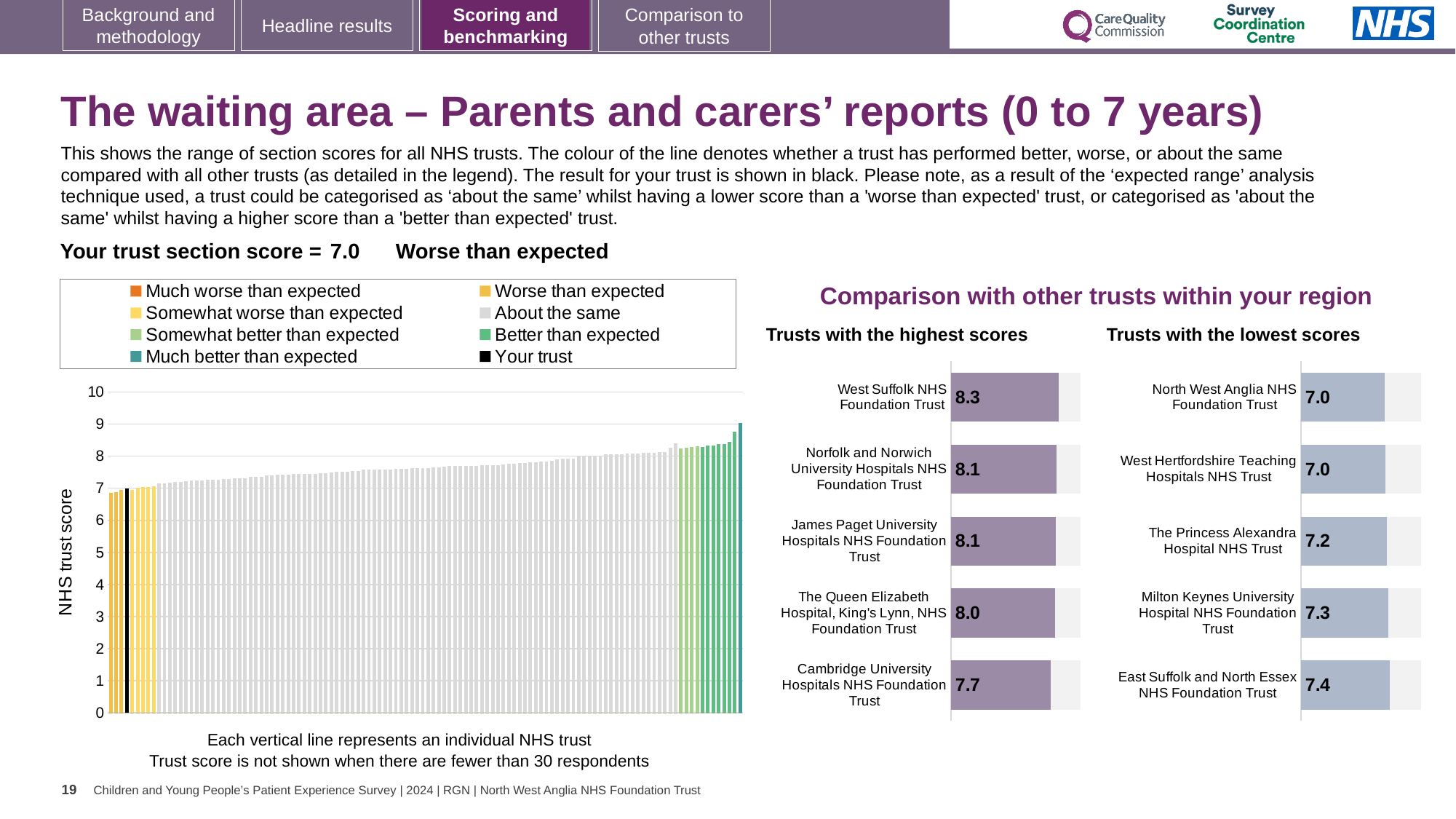
In the 'Trusts with the highest scores' chart, which trust has the highest score? West Suffolk NHS Foundation Trust In the 'Trusts with the lowest scores' chart, what is the difference between the scores of East Suffolk and North Essex NHS Foundation Trust and North West Anglia NHS Foundation Trust? 0.4 How many entries does the legend of the large chart on the left list? 8 In the 'Trusts with the highest scores' chart, what is the score for West Suffolk NHS Foundation Trust? 8.3 In the 'Trusts with the highest scores' chart, what is the score for Cambridge University Hospitals NHS Foundation Trust? 7.7 How many trusts are shown in the 'Trusts with the highest scores' chart? 5 What is the y-axis label of the large chart on the left? NHS trust score In the large chart on the left showing all NHS trusts, is the value of the black bar (your trust) greater or less than 8? less In the 'Trusts with the lowest scores' chart, what is the score for Milton Keynes University Hospital NHS Foundation Trust? 7.3 In the 'Trusts with the highest scores' chart, what is the difference between the scores of West Suffolk NHS Foundation Trust and Cambridge University Hospitals NHS Foundation Trust? 0.6 In the 'Trusts with the lowest scores' chart, which trust has the highest score? East Suffolk and North Essex NHS Foundation Trust In the 'Trusts with the lowest scores' chart, which has the larger score: Milton Keynes University Hospital NHS Foundation Trust or The Princess Alexandra Hospital NHS Trust? Milton Keynes University Hospital NHS Foundation Trust